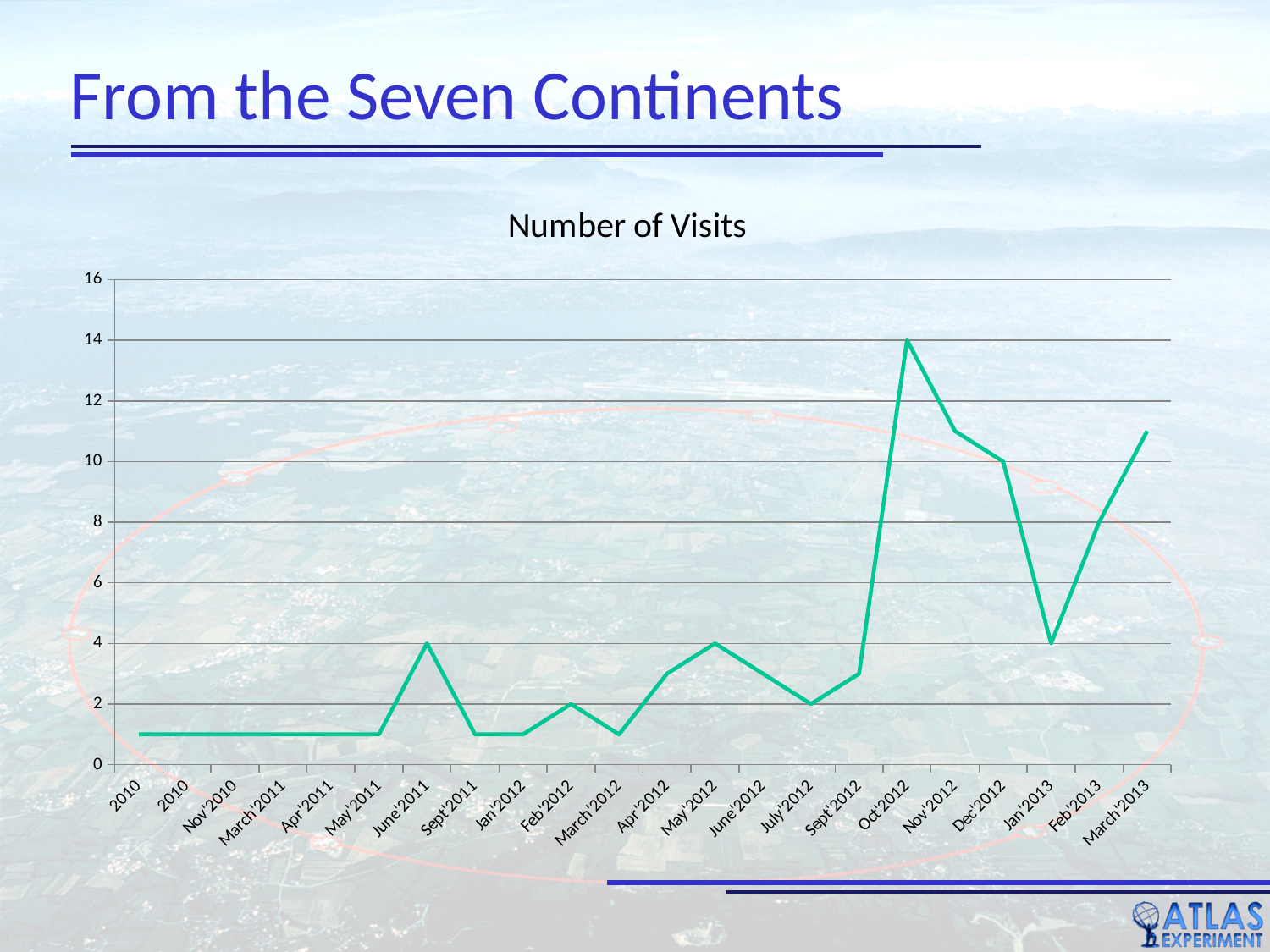
What is the difference in visits between Oct'2012 and Dec'2012? 4 What is the title of the chart? Number of Visits What kind of chart is shown on the slide? line chart What is the number of visits for Feb'2013? 8 Which has more visits, Feb'2013 or Jan'2013? Feb'2013 How many categories are shown on the x axis? 22 What is the number of visits for June'2011? 4 Do the values rise or fall from Oct'2012 to Jan'2013? fall What is the number of visits for Oct'2012? 14 Is the value for Nov'2012 greater or less than 10? greater What is the number of visits for Dec'2012? 10 Which category has the highest number of visits? Oct'2012